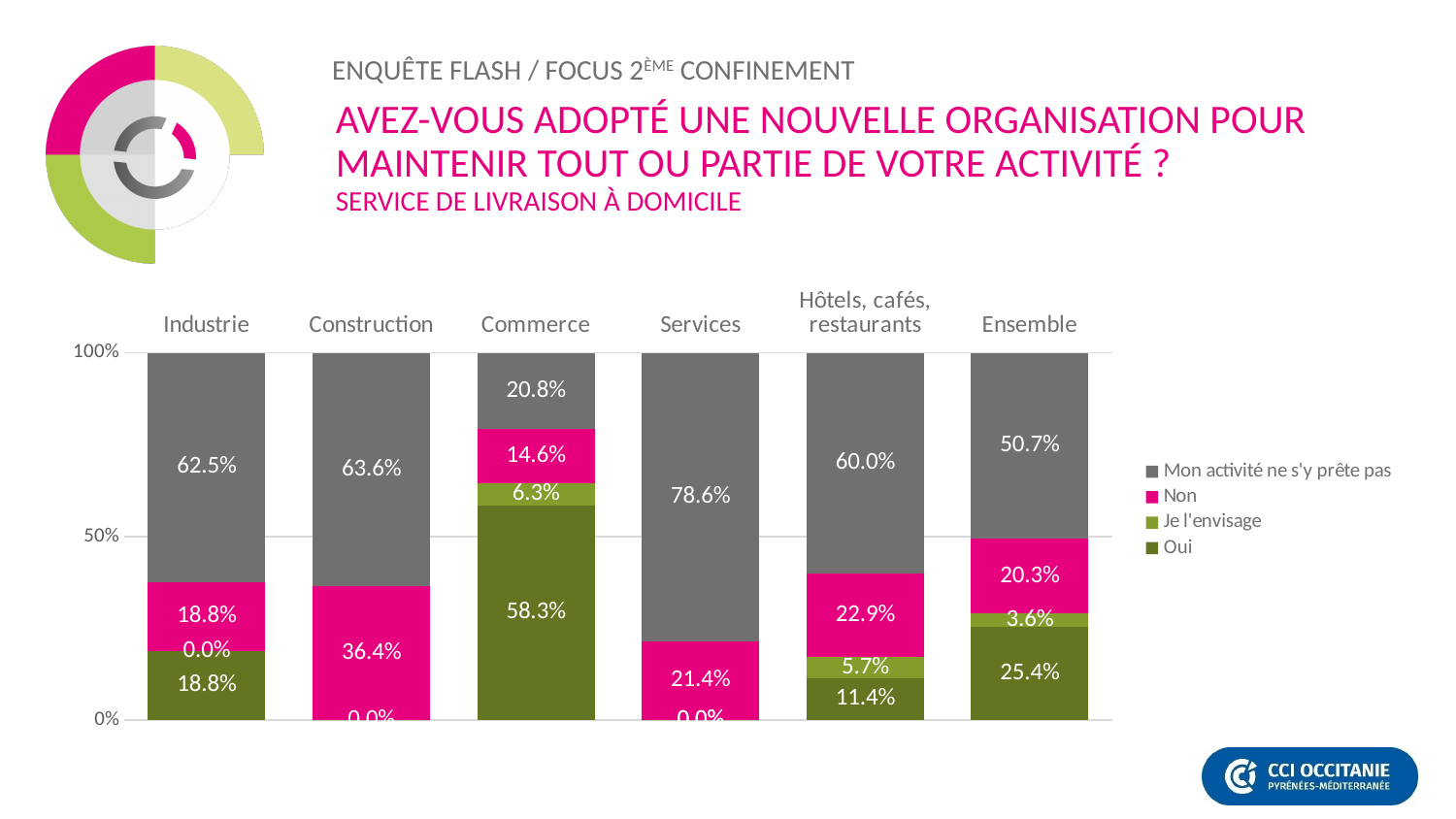
How many categories are shown along the x axis? 6 Which is larger: the "Non" value for Industrie or for Ensemble? Ensemble What kind of chart is shown on the slide? stacked bar chart What is the value of "Non" for Construction? 36.4% What is the difference between the "Oui" values for Ensemble and Hôtels, cafés, restaurants? 14.0% What is the value of "Mon activité ne s'y prête pas" for Services? 78.6% Which category has the highest value for "Oui"? Commerce How many series does the legend list? 4 What is the value of "Oui" for Commerce? 58.3% Which colour represents "Non" in the chart? pink What is the value of "Je l'envisage" for Hôtels, cafés, restaurants? 5.7% Which category has the highest value for "Mon activité ne s'y prête pas"? Services